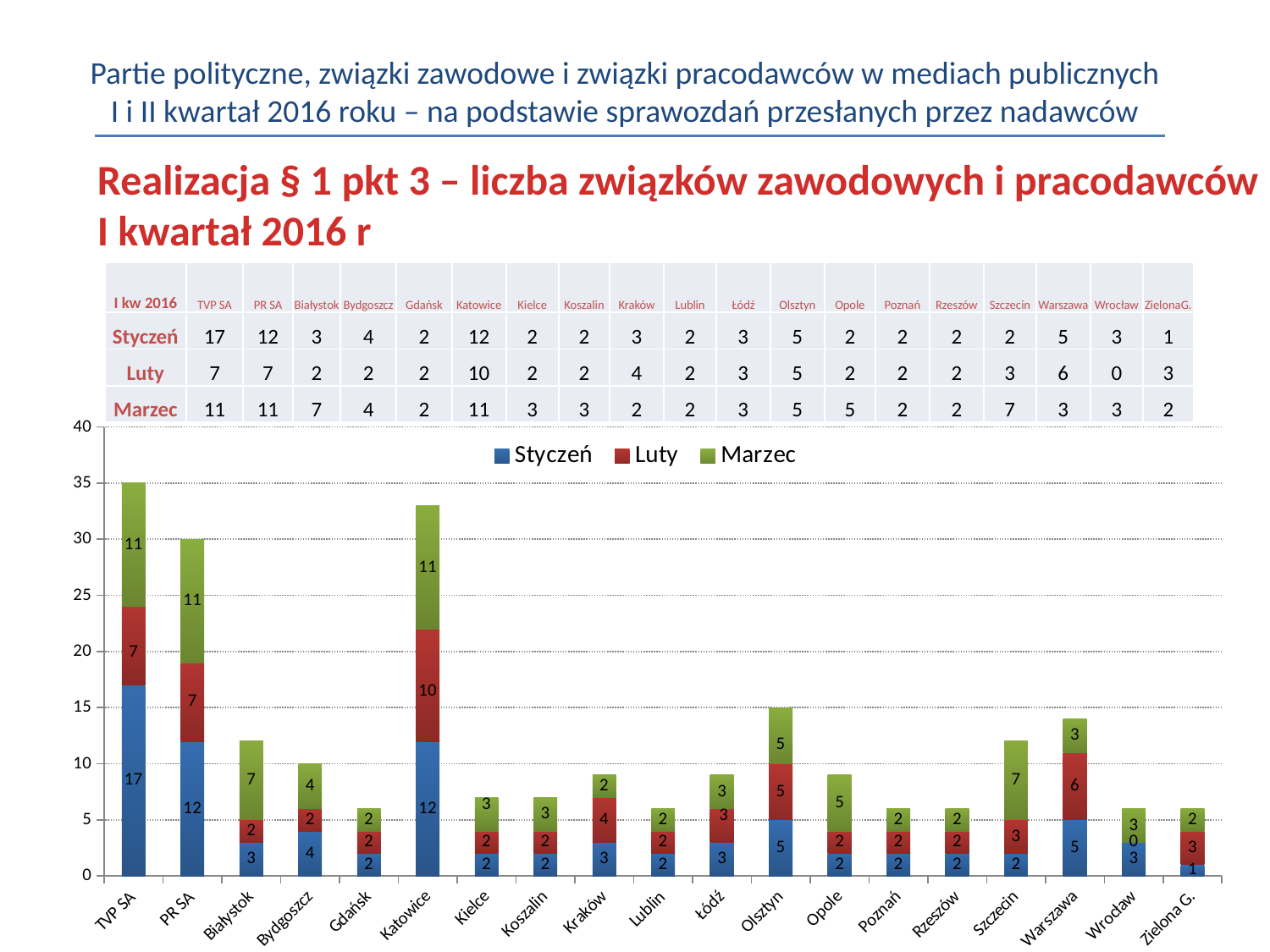
What is the total of the stacked bar for Olsztyn? 15 What kind of chart is shown on the slide? Stacked bar chart What is the total of the stacked bar for Katowice? 33 Which series is shown in green in the legend? Marzec What is the difference between the Styczeń values for TVP SA and PR SA? 5 How many categories are shown on the x axis? 19 What is the Luty value for Katowice? 10 What is the Marzec value for Szczecin? 7 What is the Styczeń value for TVP SA? 17 Which is larger, the Luty value for Warszawa or the Luty value for Szczecin? Warszawa How many series does the legend list? 3 Which category has the tallest stacked bar overall? TVP SA